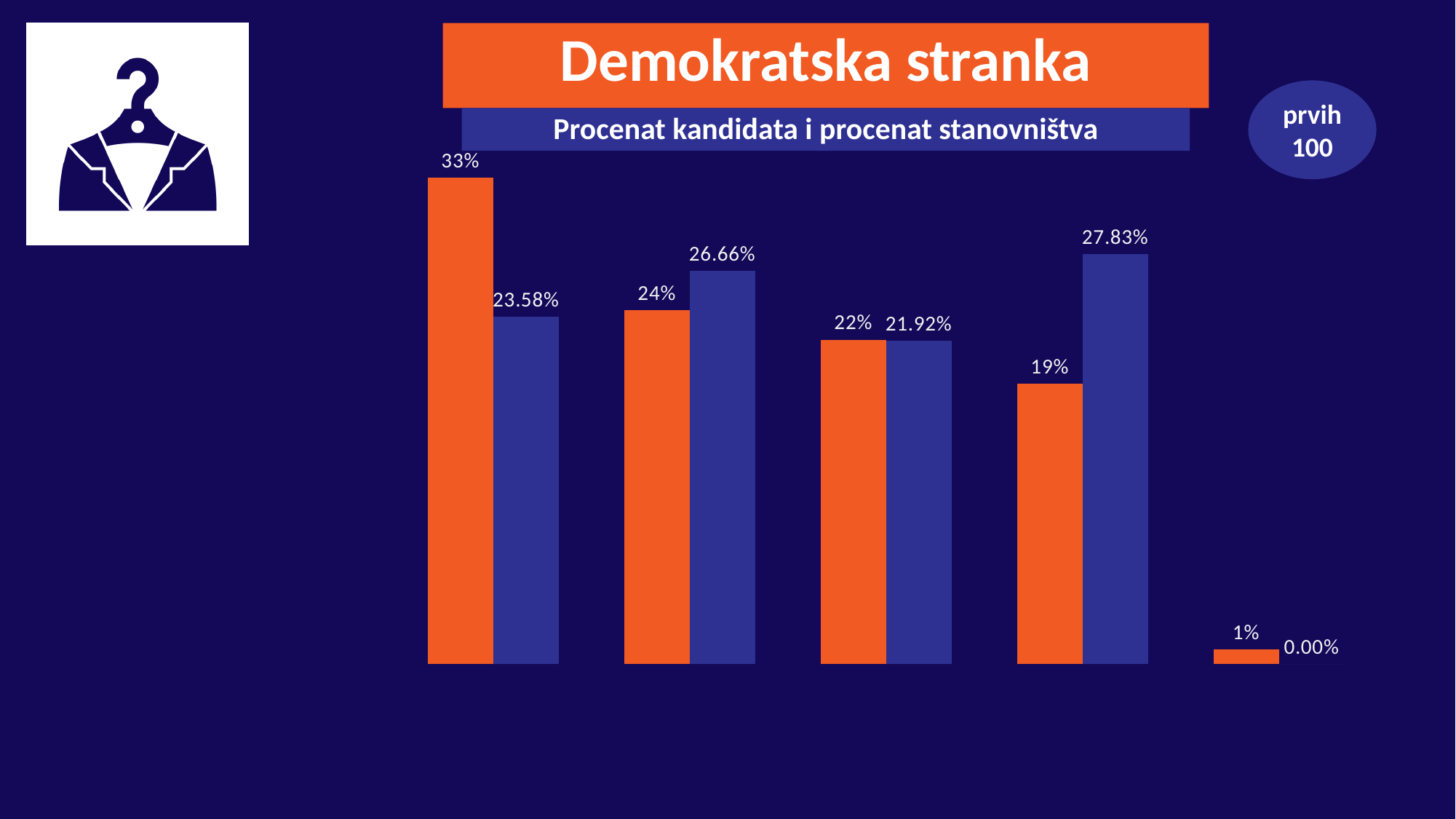
What is the value of the blue bar in the fourth group from the left? 27.83% What is the subtitle shown below the chart title 'Demokratska stranka'? Procenat kandidata i procenat stanovništva Which blue bar has the highest value? the fourth one, 27.83% What kind of chart is shown on the slide? bar chart What is the difference between the orange bar (33%) and the blue bar (23.58%) in the first group? 9.42% In the second group from the left, which bar is larger, the orange one or the blue one? the blue one What is the value of the blue bar in the first (leftmost) group? 23.58% How many groups of bars does the chart show? 5 Which orange bar has the highest value? the first (leftmost) one, 33% What is the value of the orange bar in the fourth group from the left? 19% What is the value of the blue bar in the last (rightmost) group? 0.00% What is the value of the orange bar in the first (leftmost) group? 33%